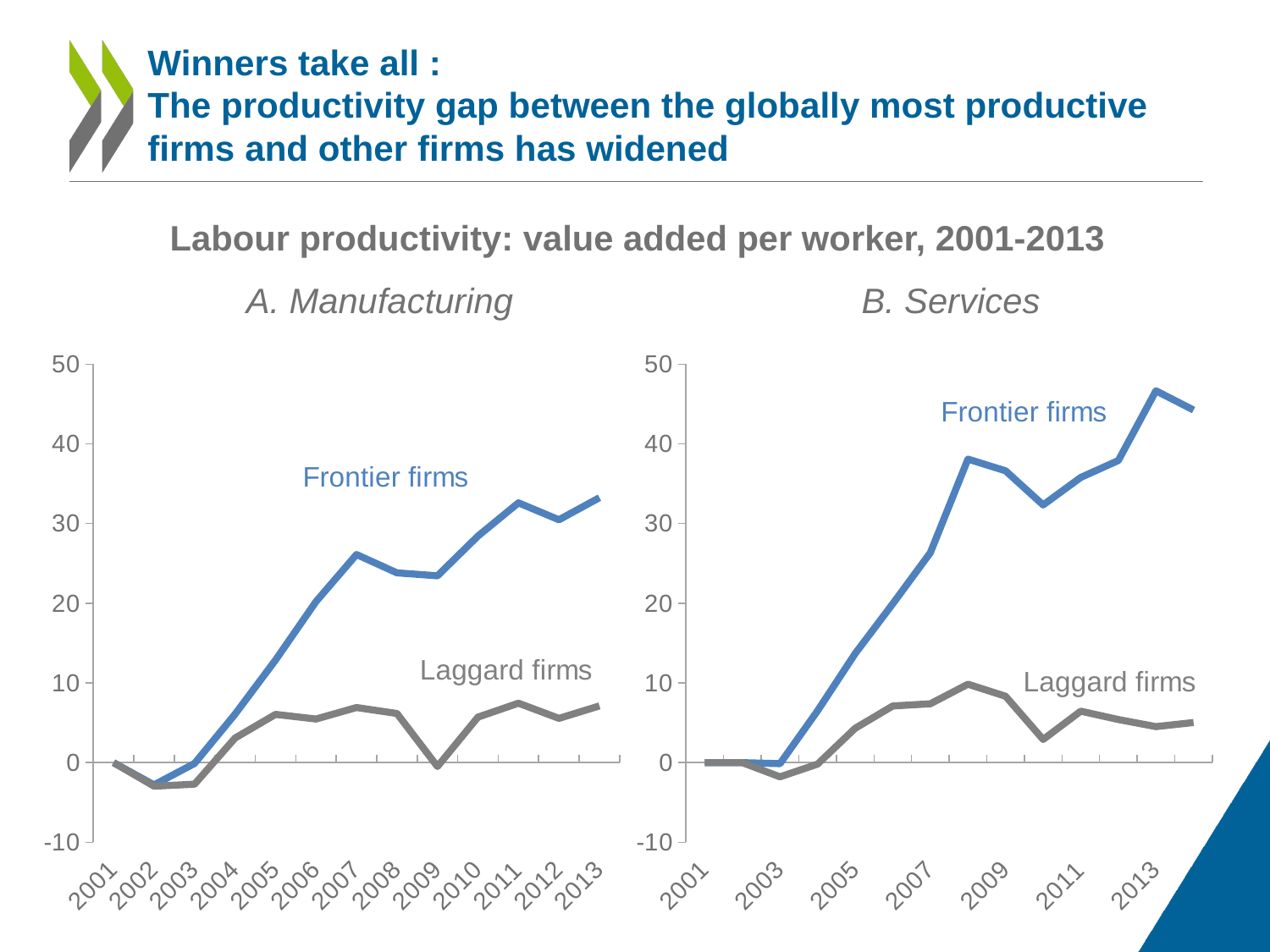
In the A. Manufacturing chart, what is the value for Frontier firms in 2001? 0 In the B. Services chart, is the value for Frontier firms in 2013 greater or less than 40? greater How many years are labelled on the x axis of the A. Manufacturing chart? 13 In the A. Manufacturing chart, is the value for Laggard firms in 2009 greater or less than 10? less In the B. Services chart, in which year do Frontier firms reach their highest value? 2013 In the A. Manufacturing chart, is the value for Frontier firms in 2013 greater or less than 30? greater What is the overall title shown above the two charts? Labour productivity: value added per worker, 2001-2013 In the B. Services chart, which series has the larger value in 2013, Frontier firms or Laggard firms? Frontier firms How many series are plotted in the B. Services chart? 2 In the A. Manufacturing chart, in which year do Frontier firms reach their lowest value? 2002 In the B. Services chart, do the values for Frontier firms generally rise or fall from 2001 to 2013? Rise What kind of chart is used in panel A. Manufacturing? Line chart